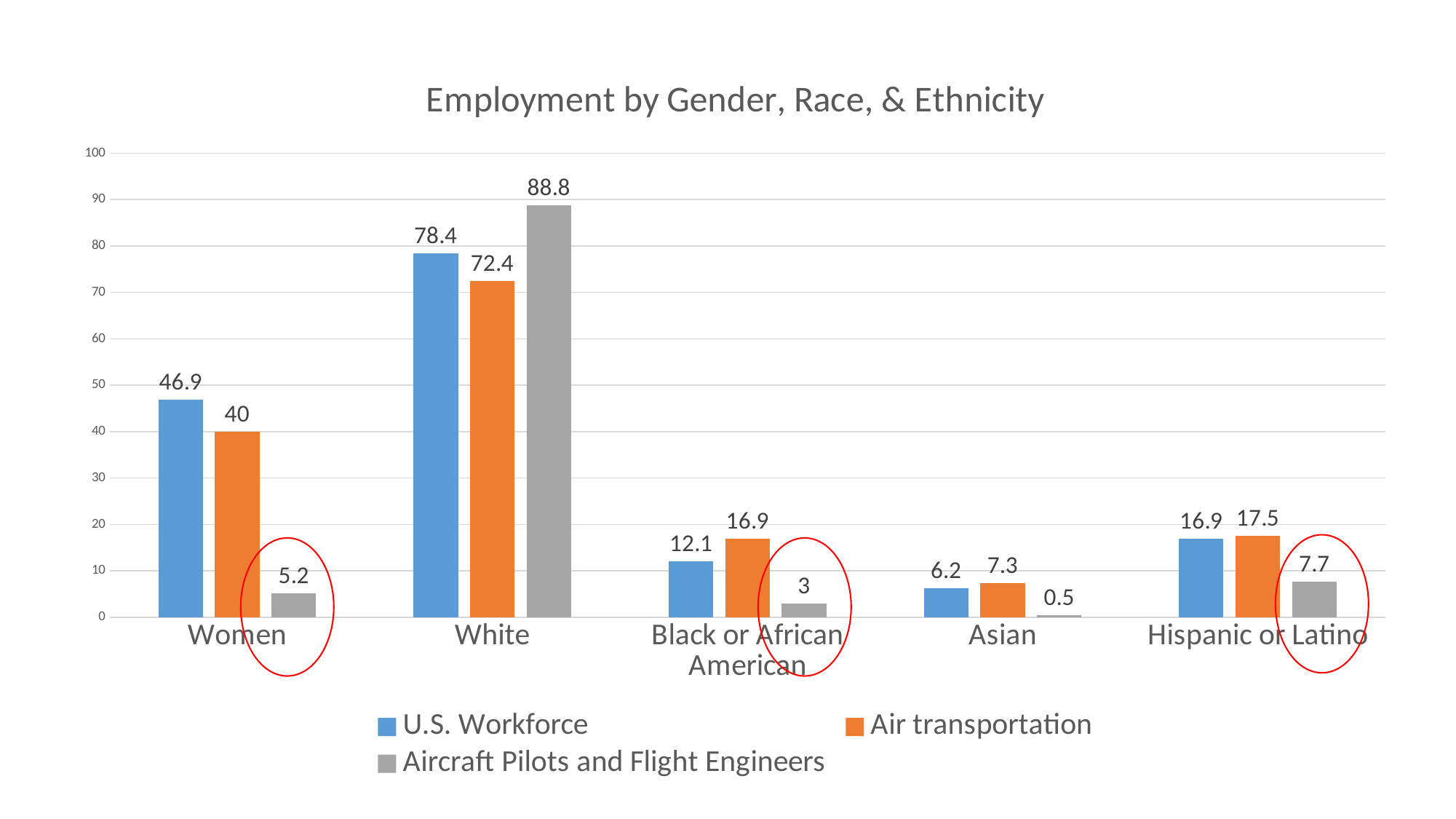
What is the title of the chart? Employment by Gender, Race, & Ethnicity What kind of chart is shown on the slide? Bar chart Which category has the highest value in the Aircraft Pilots and Flight Engineers series? White Which category has the lowest value in the U.S. Workforce series? Asian What is the value for Women in the U.S. Workforce series? 46.9 How many series does the legend list? 3 What is the value for Aircraft Pilots and Flight Engineers in the White category? 88.8 How many categories are shown on the x axis? 5 What is the difference between the U.S. Workforce and Air transportation values for Women? 6.9 What is the Aircraft Pilots and Flight Engineers value for Asian? 0.5 For Hispanic or Latino, which is larger: the U.S. Workforce value or the Aircraft Pilots and Flight Engineers value? U.S. Workforce What is the Air transportation value for Black or African American? 16.9